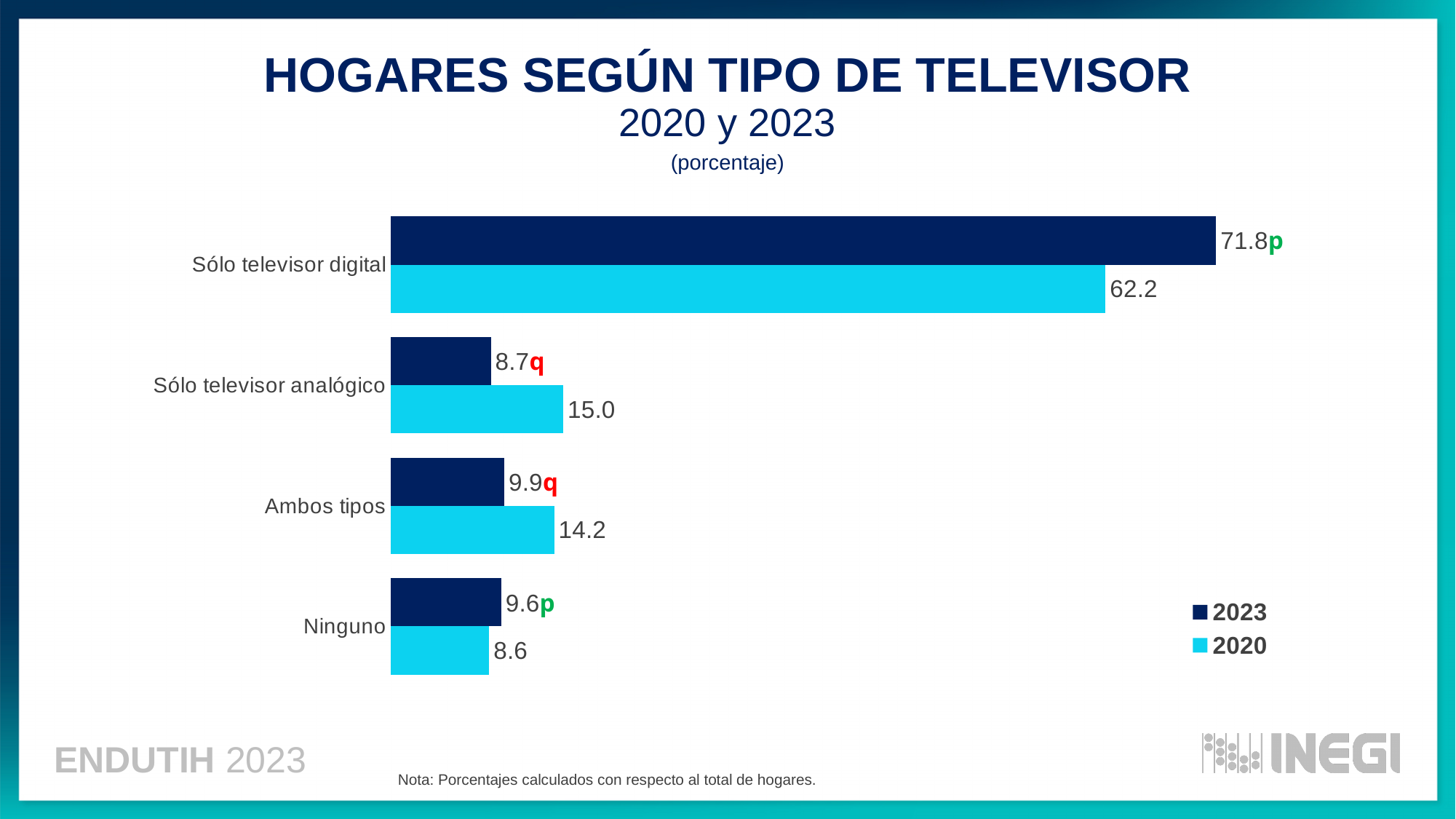
How many series does the legend list? 2 What kind of chart is shown on the slide? Bar chart What is the 2023 value for Sólo televisor digital? 71.8 Which series is shown in dark navy blue according to the legend? 2023 What is the 2020 value for Sólo televisor analógico? 15.0 Which category has the lowest 2020 value? Ninguno How many categories are shown on the chart? 4 What is the difference between the 2023 and 2020 values for Sólo televisor digital? 9.6 Which is larger for Ambos tipos, the 2023 value or the 2020 value? 2020 Which category has the highest 2023 value? Sólo televisor digital What is the 2023 value for Ninguno? 9.6 What is the 2020 value for Ambos tipos? 14.2